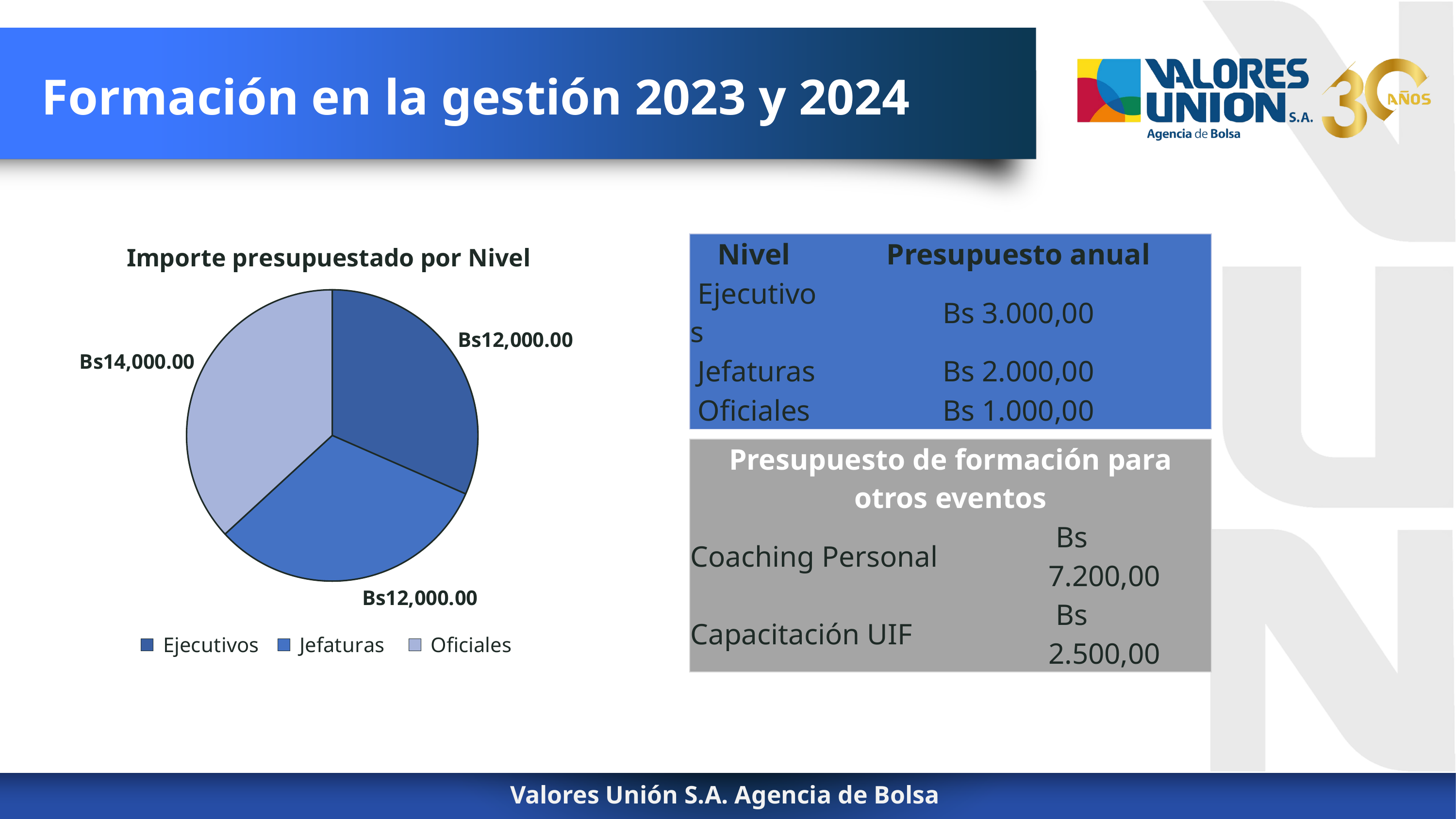
What is the value shown for Jefaturas in the pie chart? Bs12,000.00 What is the value shown for Ejecutivos in the pie chart? Bs12,000.00 How many entries does the legend of the pie chart list? 3 What is the difference between the values for Oficiales and Jefaturas in the pie chart? Bs2,000.00 What type of chart is shown on the slide? Pie chart Which legend entry is shown in the lightest blue colour in the pie chart? Oficiales How many slices does the pie chart have? 3 Which category has the largest slice in the pie chart? Oficiales What is the title of the chart on the slide? Importe presupuestado por Nivel Which is larger in the pie chart, Oficiales or Ejecutivos? Oficiales What is the value shown for Oficiales in the pie chart? Bs14,000.00 What is the total of all slices in the pie chart? Bs38,000.00